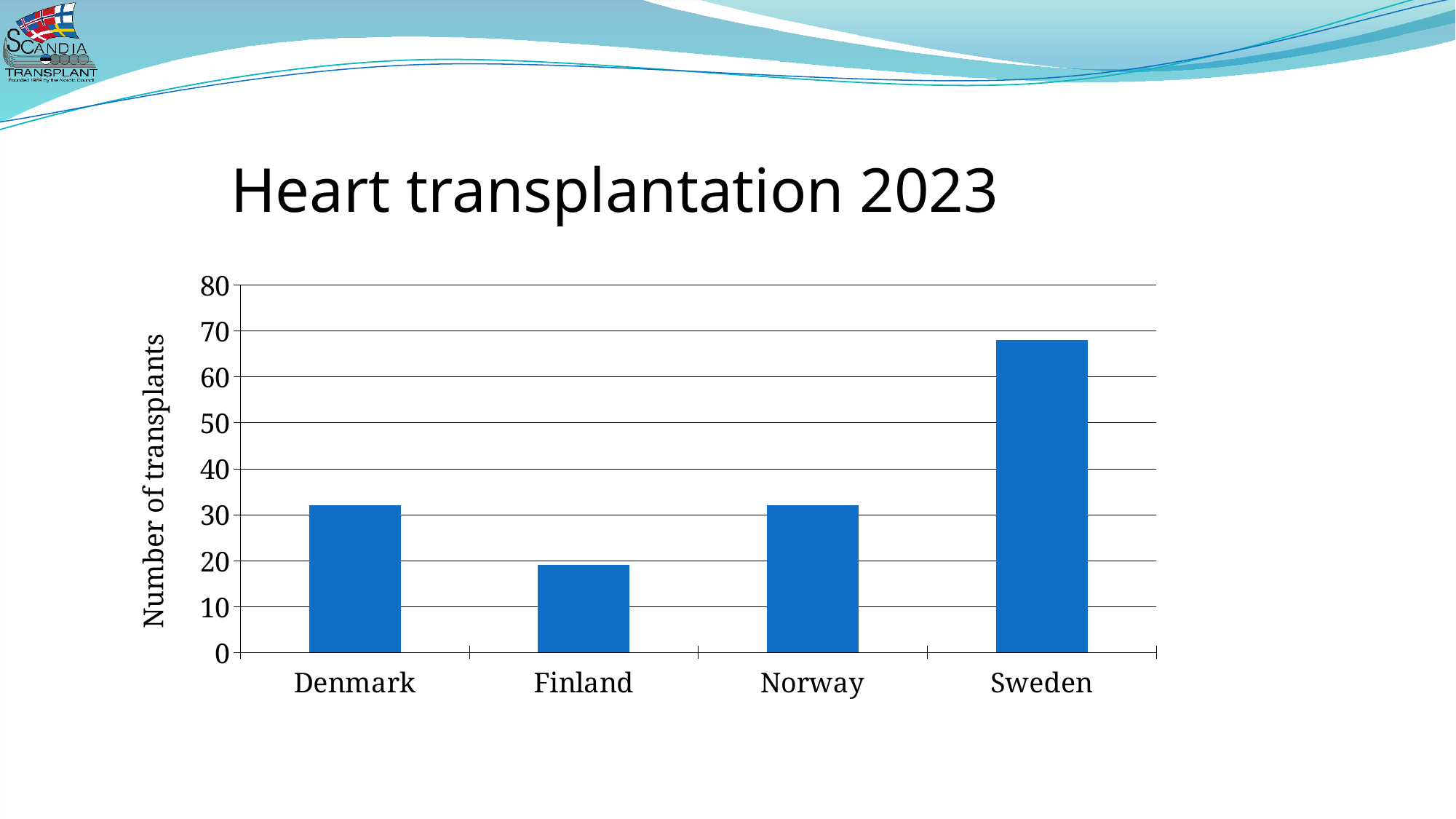
Which is larger, the value for Finland or the value for Denmark? Denmark What is the title of the slide containing the chart? Heart transplantation 2023 Which country has the lowest number of heart transplants in the chart? Finland Is the value for Norway greater or less than 40? less Is the value for Denmark greater or less than 30? greater How many countries are shown on the x axis of the chart? 4 Which is larger, the value for Sweden or the value for Norway? Sweden What is the label on the vertical axis of the chart? Number of transplants What kind of chart is shown on the slide? bar chart Is the value for Sweden greater or less than 60? greater Which country has the highest number of heart transplants in the chart? Sweden